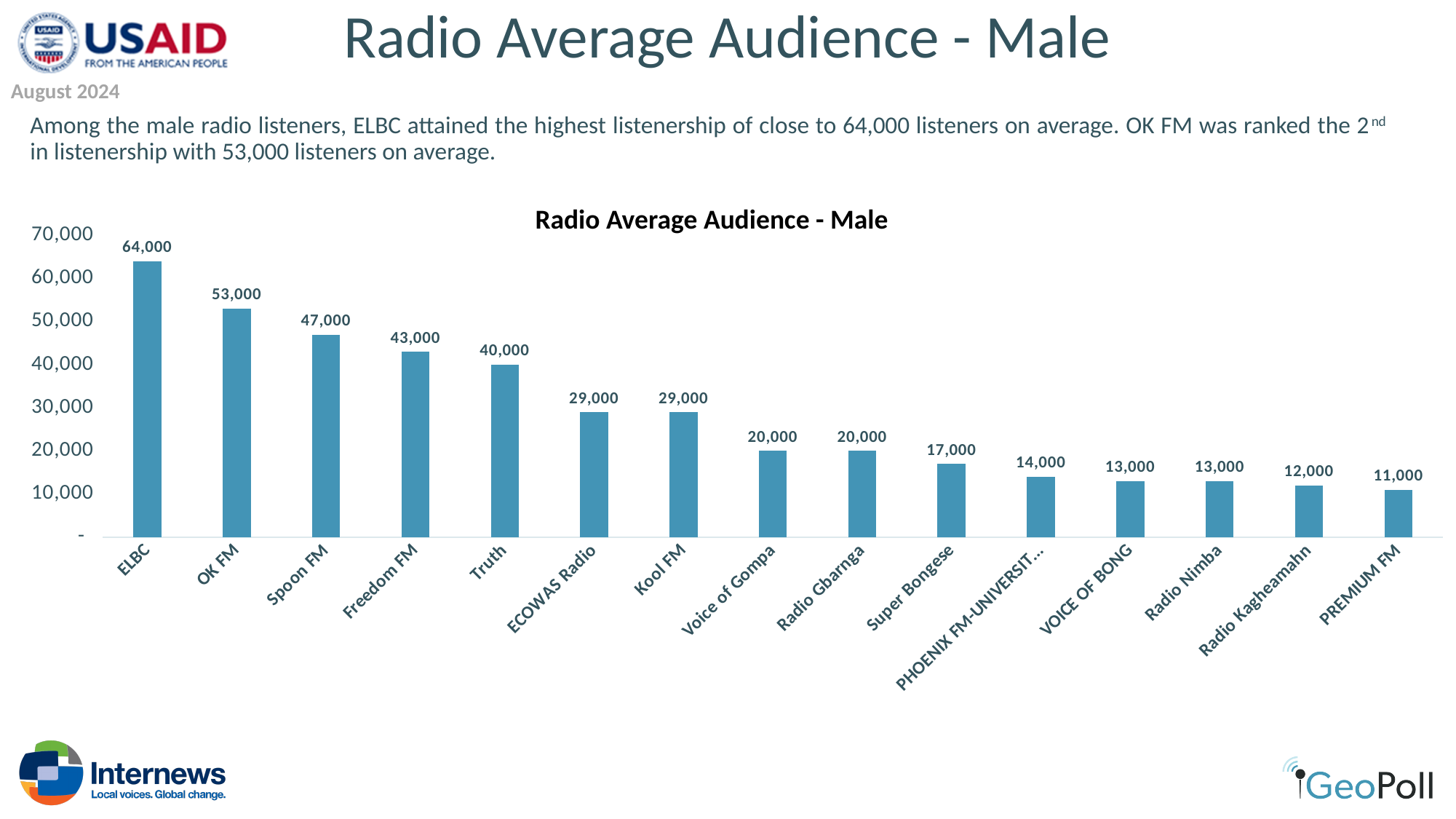
What is the difference between the average male audience of Freedom FM and Truth? 3,000 Which station has the lowest average male audience? PREMIUM FM What is the average male audience for Radio Gbarnga? 20,000 What is the average male audience for Spoon FM? 47,000 Which station has the highest average male audience? ELBC Which has a larger average male audience, Super Bongese or Voice of Gompa? Voice of Gompa What is the average male audience for Radio Kagheamahn? 12,000 What kind of chart is shown on the slide? Bar chart What is the difference between the average male audience of ELBC and OK FM? 11,000 Is the value for Kool FM greater or less than 30,000? less How many radio stations are shown in the chart? 15 What is the title of the chart? Radio Average Audience - Male